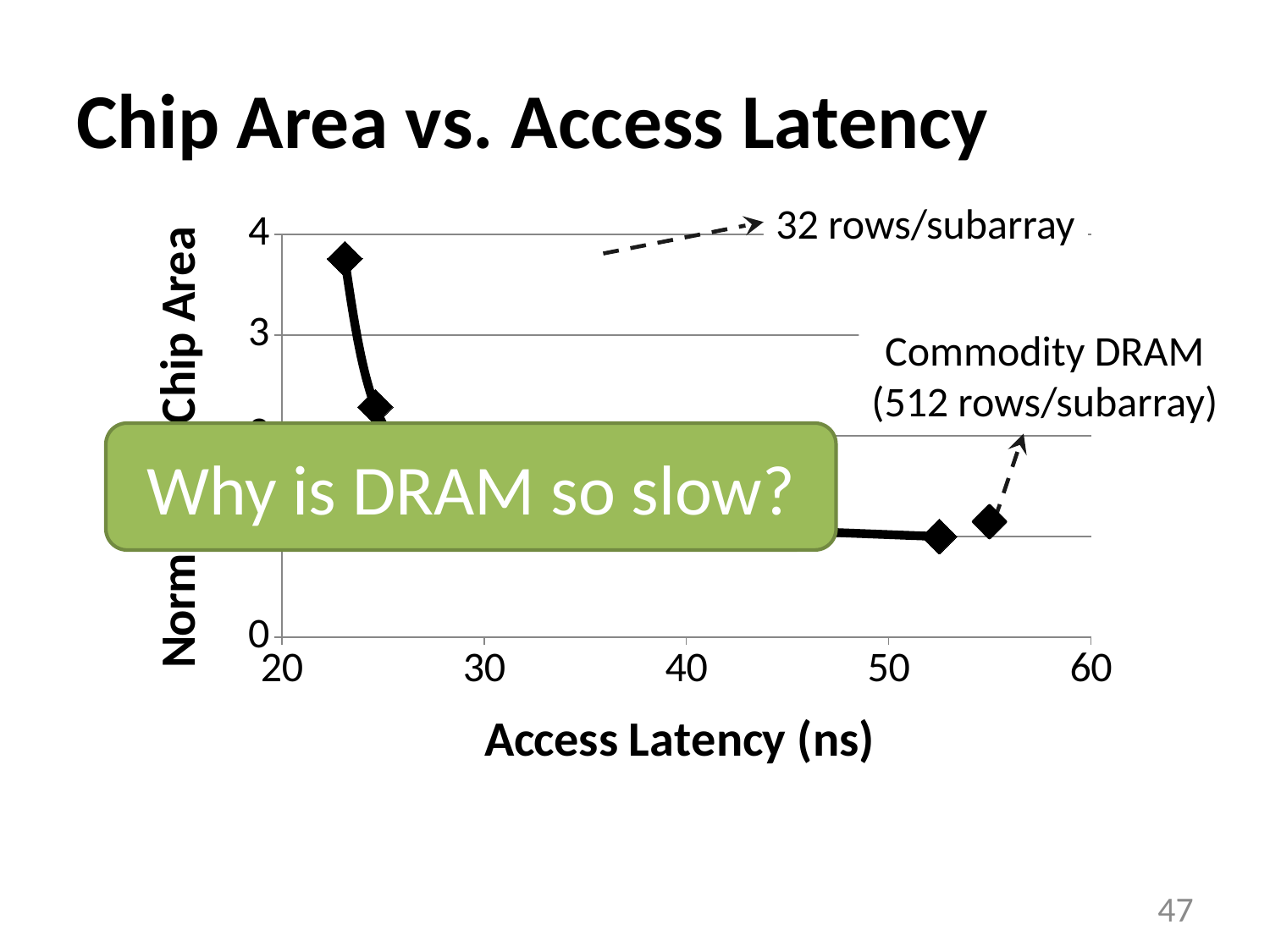
Is the access latency for the 32 rows/subarray point greater or less than 30 ns? less Which has the larger normalized chip area: the 32 rows/subarray point or the Commodity DRAM (512 rows/subarray) point? 32 rows/subarray Is the access latency for the 32 rows/subarray point greater or less than 20 ns? greater What kind of chart is shown on the slide? line chart What is the label of the x axis of the chart? Access Latency (ns) Is the normalized chip area for Commodity DRAM (512 rows/subarray) greater or less than 2? less Which annotated point has the highest normalized chip area? 32 rows/subarray Which has the higher access latency: the 32 rows/subarray point or the Commodity DRAM (512 rows/subarray) point? Commodity DRAM (512 rows/subarray) What is the title of the chart on the slide? Chip Area vs. Access Latency As access latency increases along the x axis, does the normalized chip area generally rise or fall? fall